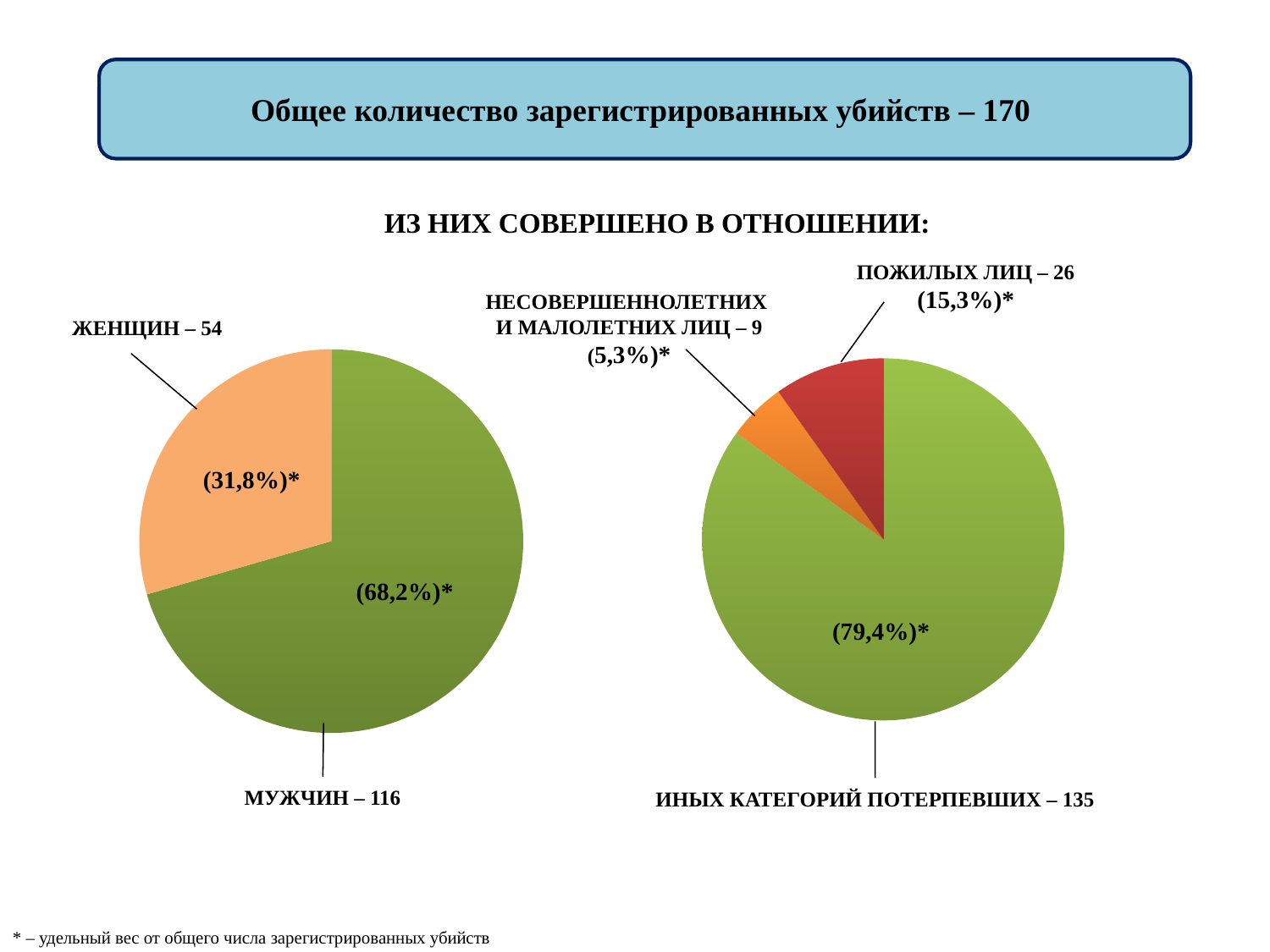
On the left pie chart, what is the value for ЖЕНЩИН? 54 On the right pie chart, what is the value for НЕСОВЕРШЕННОЛЕТНИХ И МАЛОЛЕТНИХ ЛИЦ? 9 On the left pie chart, what share of the pie does the ЖЕНЩИН slice represent? 31,8% On the left pie chart, what share of the pie does the МУЖЧИН slice represent? 68,2% On the right pie chart, what share of the pie does the ИНЫХ КАТЕГОРИЙ ПОТЕРПЕВШИХ slice represent? 79,4% How many slices does the right pie chart have? 3 On the right pie chart, which category has the smallest slice? НЕСОВЕРШЕННОЛЕТНИХ И МАЛОЛЕТНИХ ЛИЦ On the left pie chart, what is the value for МУЖЧИН? 116 What type of chart is shown on the left of the slide? Pie chart On the right pie chart, which category has the largest slice? ИНЫХ КАТЕГОРИЙ ПОТЕРПЕВШИХ On the left pie chart, what is the difference between the values for МУЖЧИН and ЖЕНЩИН? 62 On the right pie chart, what is the value for ПОЖИЛЫХ ЛИЦ? 26